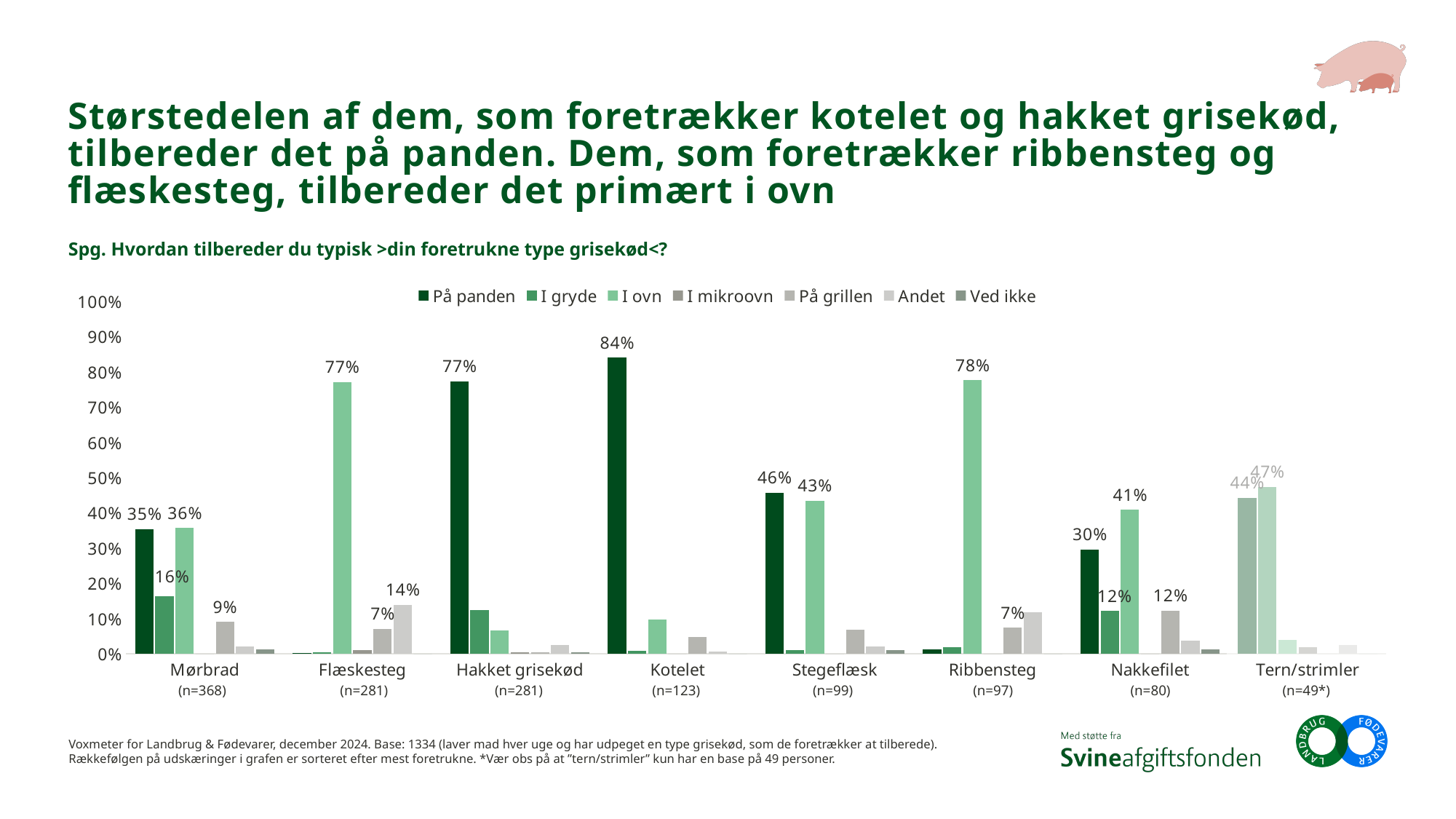
What is the difference between the 'På panden' values for Kotelet and Hakket grisekød? 7 percentage points What is the value for 'I ovn' for Ribbensteg? 78% What is the value for 'I ovn' for Nakkefilet? 41% What is the value for 'På panden' for Kotelet? 84% What is the value for 'Andet' for Flæskesteg? 14% Is the value for 'I ovn' for Kotelet greater or less than 20%? less How many cut categories are shown on the x axis? 8 For Mørbrad, which is larger: 'På panden' or 'I ovn'? I ovn Which category has the highest value for 'På panden'? Kotelet How many series does the legend list? 7 What kind of chart is shown on the slide? Bar chart What is the difference between the 'På panden' and 'I ovn' values for Stegeflæsk? 3 percentage points